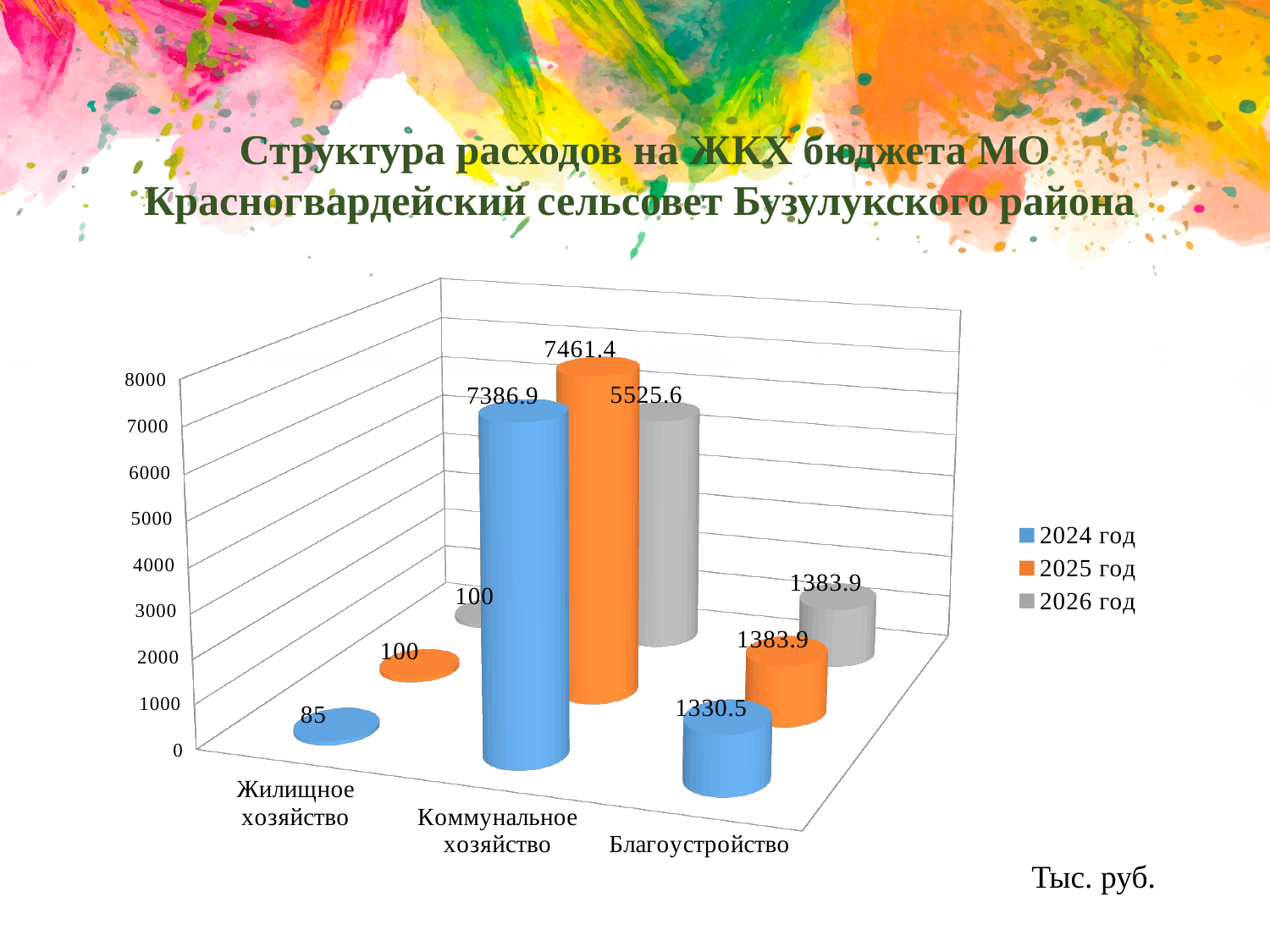
Which is larger for Коммунальное хозяйство: the 2024 год value or the 2026 год value? 2024 год What is the value for Жилищное хозяйство in the 2024 год series? 85 What kind of chart is shown on the slide? Bar chart Which category has the highest value in the 2024 год series? Коммунальное хозяйство What is the value for Благоустройство in the 2026 год series? 1383.9 What is the difference between the 2025 год and 2026 год values for Коммунальное хозяйство? 1935.8 What is the value for Коммунальное хозяйство in the 2025 год series? 7461.4 How many series does the legend list? 3 What is the difference between the 2025 год and 2024 год values for Благоустройство? 53.4 How many categories are shown on the x axis? 3 Which category has the lowest value in the 2025 год series? Жилищное хозяйство What is the value for Коммунальное хозяйство in the 2026 год series? 5525.6